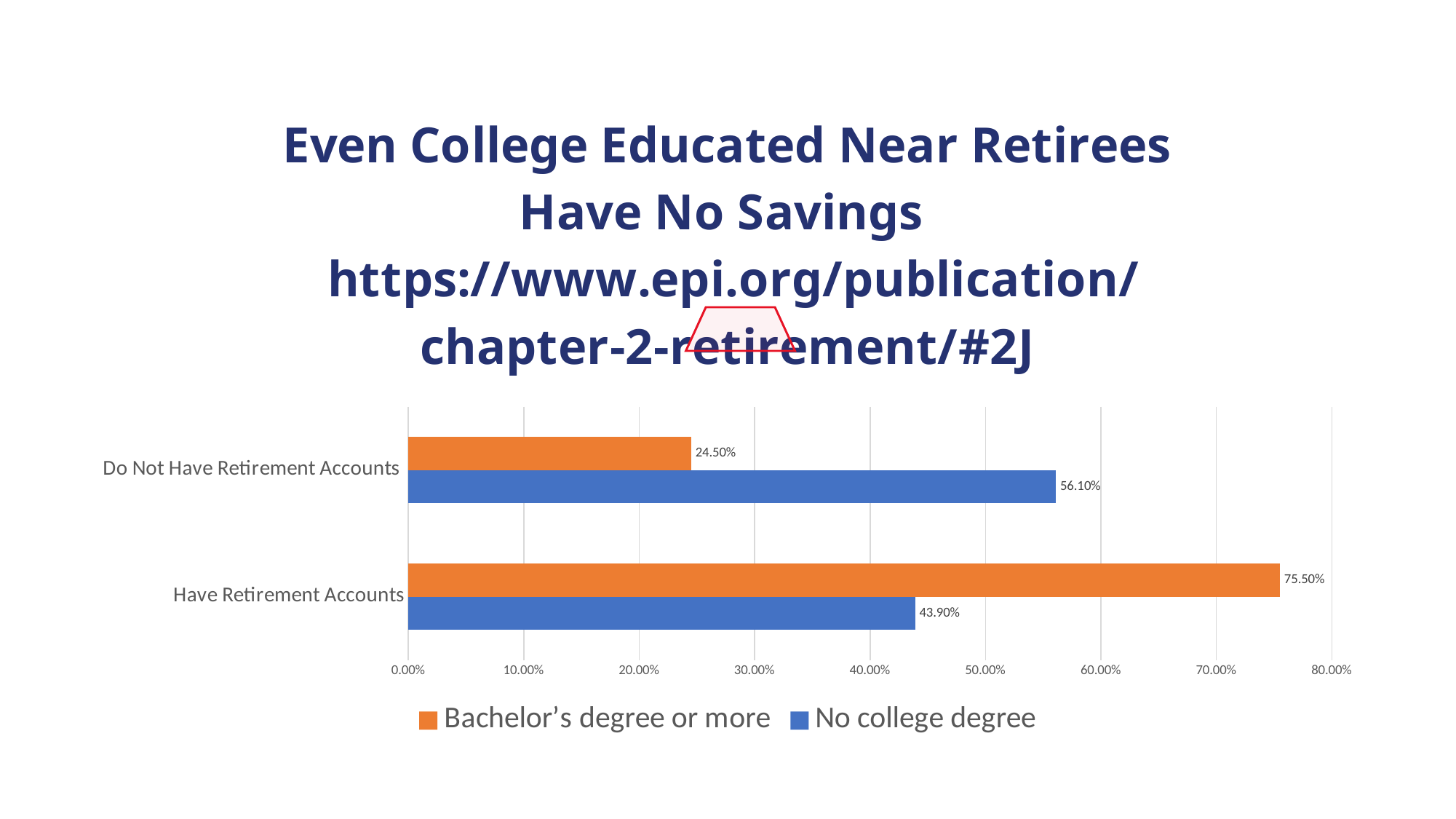
Which category has the lowest value for the 'No college degree' series? Have Retirement Accounts What percentage of near retirees with a Bachelor's degree or more have retirement accounts? 75.50% What is the value for 'Bachelor's degree or more' in the 'Do Not Have Retirement Accounts' category? 24.50% How many series does the legend list? 2 What percentage of near retirees with no college degree do not have retirement accounts? 56.10% What is the value for 'No college degree' in the 'Have Retirement Accounts' category? 43.90% What is the difference between the 'Bachelor's degree or more' and 'No college degree' values in the 'Have Retirement Accounts' category? 31.60% How many categories are shown on the chart? 2 In the 'Do Not Have Retirement Accounts' category, which series has the larger value? No college degree Which category has the highest value for the 'Bachelor's degree or more' series? Have Retirement Accounts Is the 'No college degree' value for 'Do Not Have Retirement Accounts' greater or less than 50.00%? greater What kind of chart is shown on the slide? Bar chart